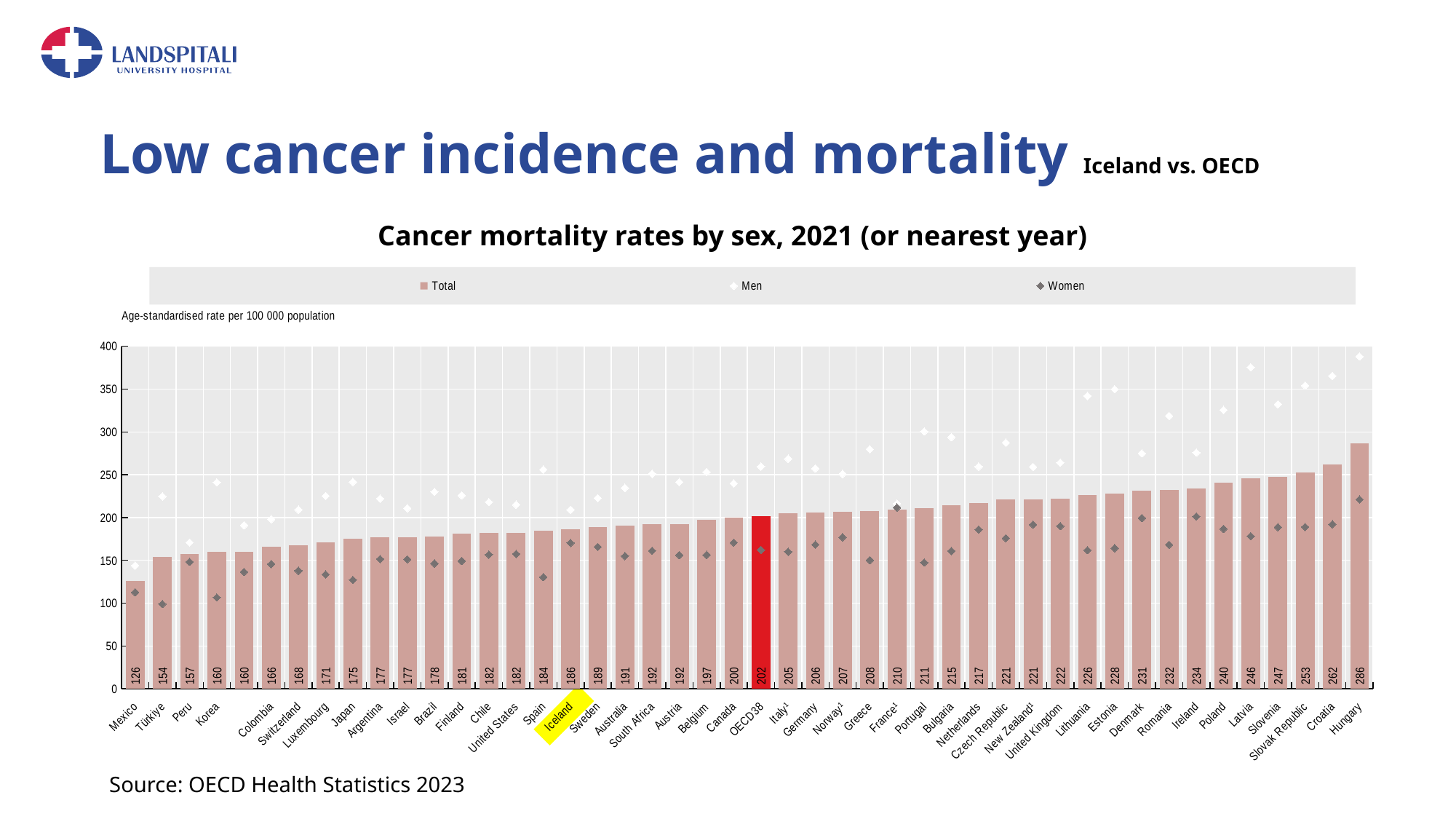
Which bar is coloured red on the chart? OECD38 What kind of chart is used to show the total cancer mortality rates? Bar chart What is the total cancer mortality rate shown for Iceland? 186 Which has the higher total cancer mortality rate, Iceland or Sweden? Sweden Is the Men value for Hungary greater or less than 350? greater What is the total cancer mortality rate shown for Canada? 200 How much higher is the OECD38 total rate than Iceland's total rate? 16 Which country has the highest total cancer mortality rate on the chart? Hungary What is the total cancer mortality rate shown for OECD38? 202 Which country has the lowest total cancer mortality rate on the chart? Mexico How many series does the legend list? 3 Is the Women value for Mexico greater or less than 150? less